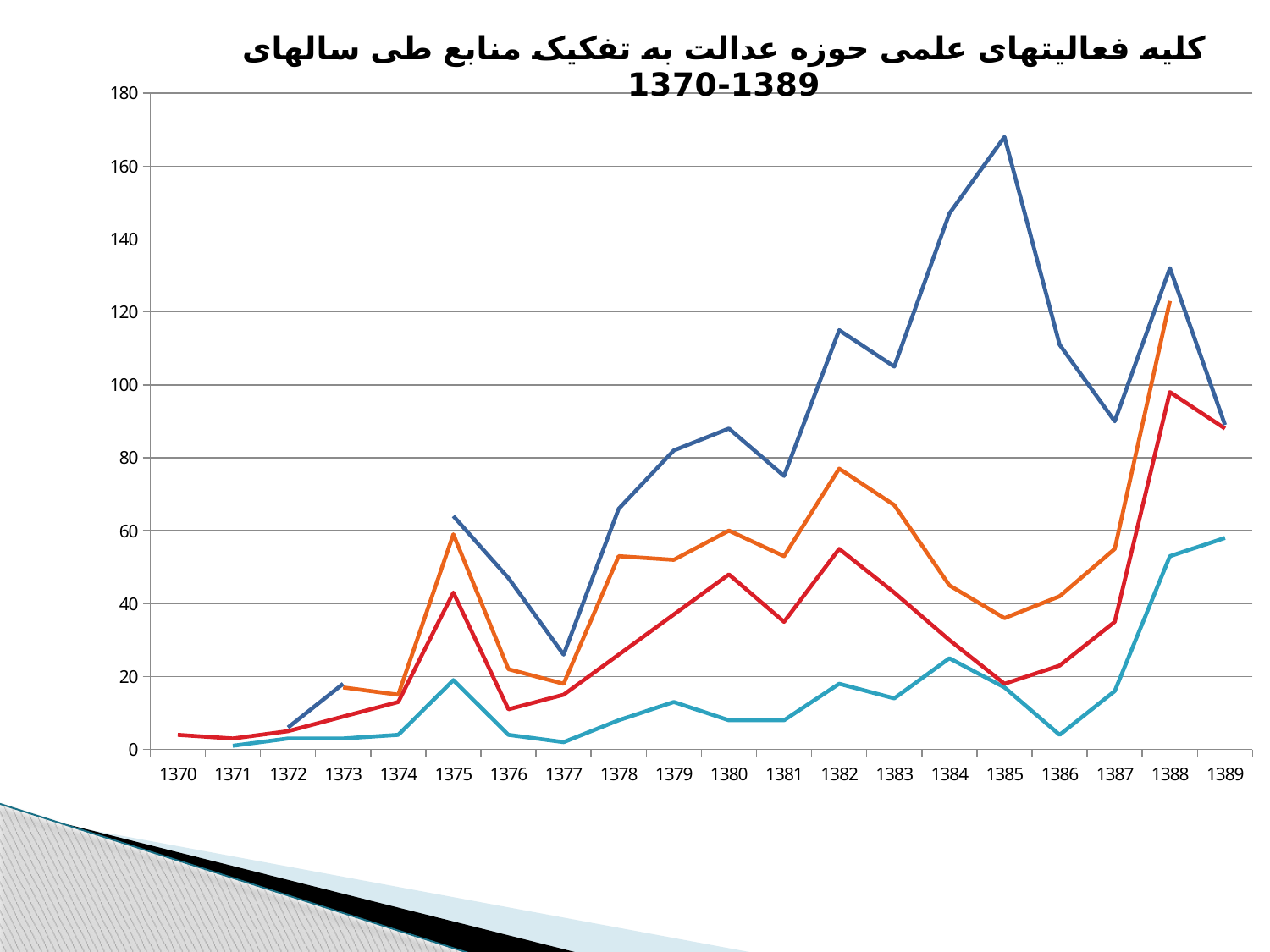
In which year does the dark blue line reach its highest value? 1385 Is the value of the red line in 1376 greater or less than 20? less Is the value of the orange line in 1388 greater or less than 100? greater In 1385, which line has the larger value, the dark blue line or the orange line? dark blue line Is the value of the dark blue line in 1385 greater or less than 160? greater In which year does the red line reach its highest value? 1388 What kind of chart is shown on the slide? line chart How many years are shown along the x axis of the chart? 20 How many lines are plotted on the chart? 4 Does the dark blue line rise or fall between 1385 and 1387? fall In which year does the orange line reach its highest value? 1388